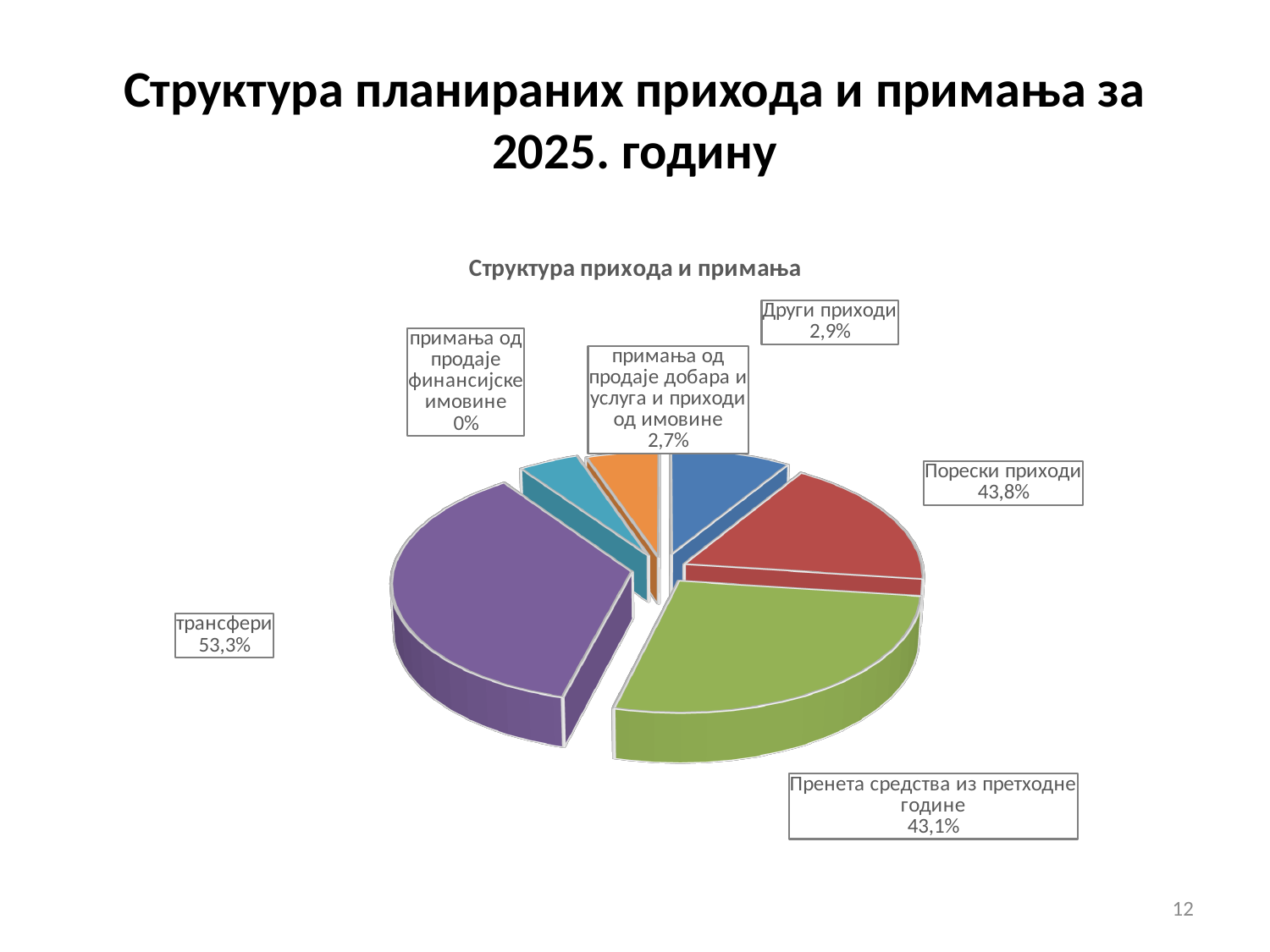
What percentage is shown for трансфери? 53,3% Which is larger, the share for Порески приходи or the share for Пренета средства из претходне године? Порески приходи Which category has the smallest share of the pie? примања од продаје финансијске имовине What percentage is shown for примања од продаје финансијске имовине? 0% What percentage is shown for Други приходи? 2,9% How many categories are shown in the pie chart? 6 What is the chart's title? Структура прихода и примања Which category has the largest share of the pie? трансфери What percentage is shown for Порески приходи? 43,8% What kind of chart is shown on the slide? pie chart What percentage is shown for примања од продаје добара и услуга и приходи од имовине? 2,7% What percentage is shown for Пренета средства из претходне године? 43,1%